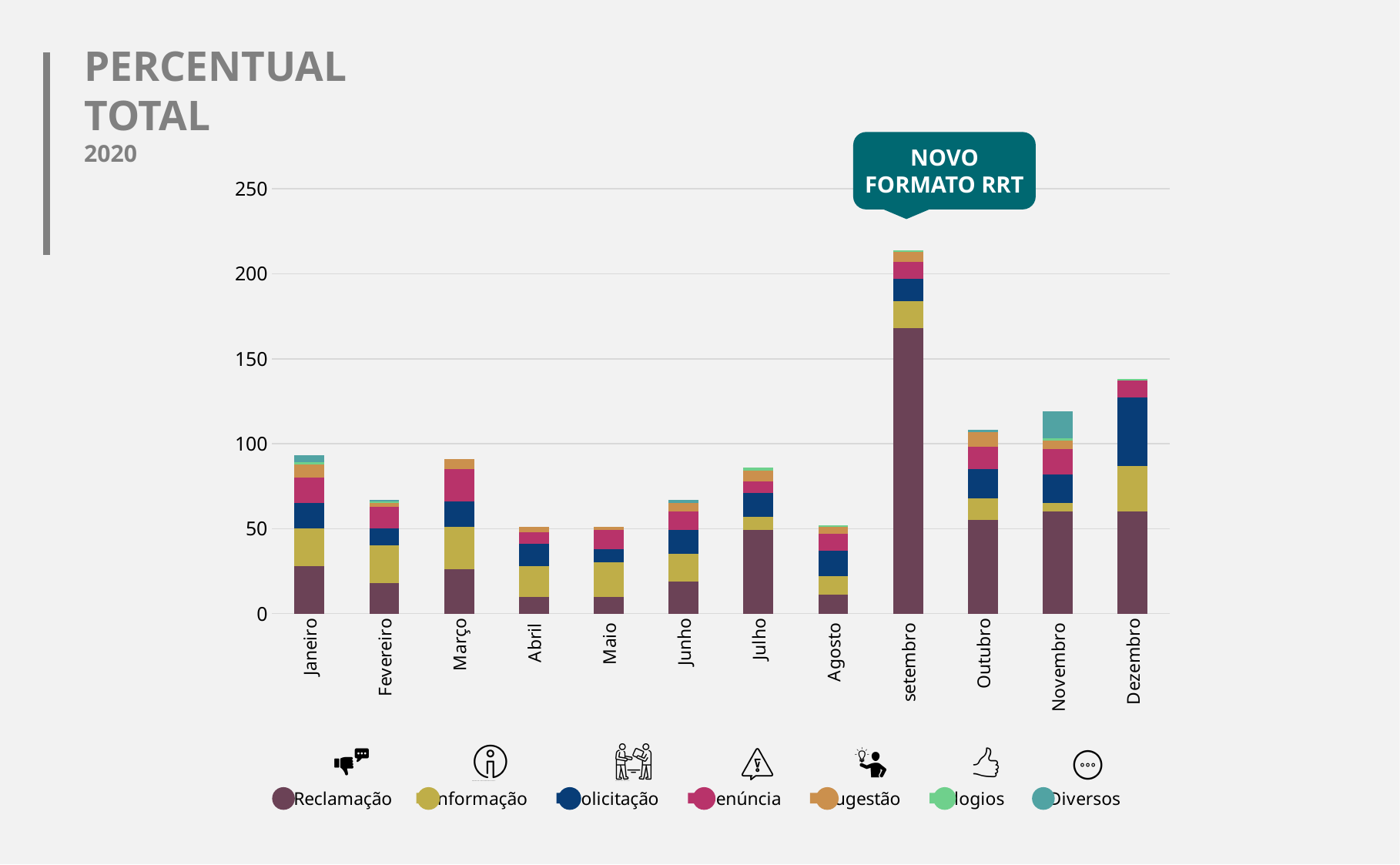
Is the total for setembro greater or less than 200? greater What does the callout above the setembro bar say? NOVO FORMATO RRT Which month has the larger total bar, Janeiro or Fevereiro? Janeiro What is the title of the chart on the slide? PERCENTUAL TOTAL 2020 Which month has the highest total bar? setembro Is the total for Novembro greater or less than 100? greater Is the total for Abril greater or less than 100? less How many series does the legend list? 7 Which month has the larger total bar, Dezembro or Novembro? Dezembro What kind of chart is shown on the slide? Stacked bar chart How many months (categories) are shown on the x axis? 12